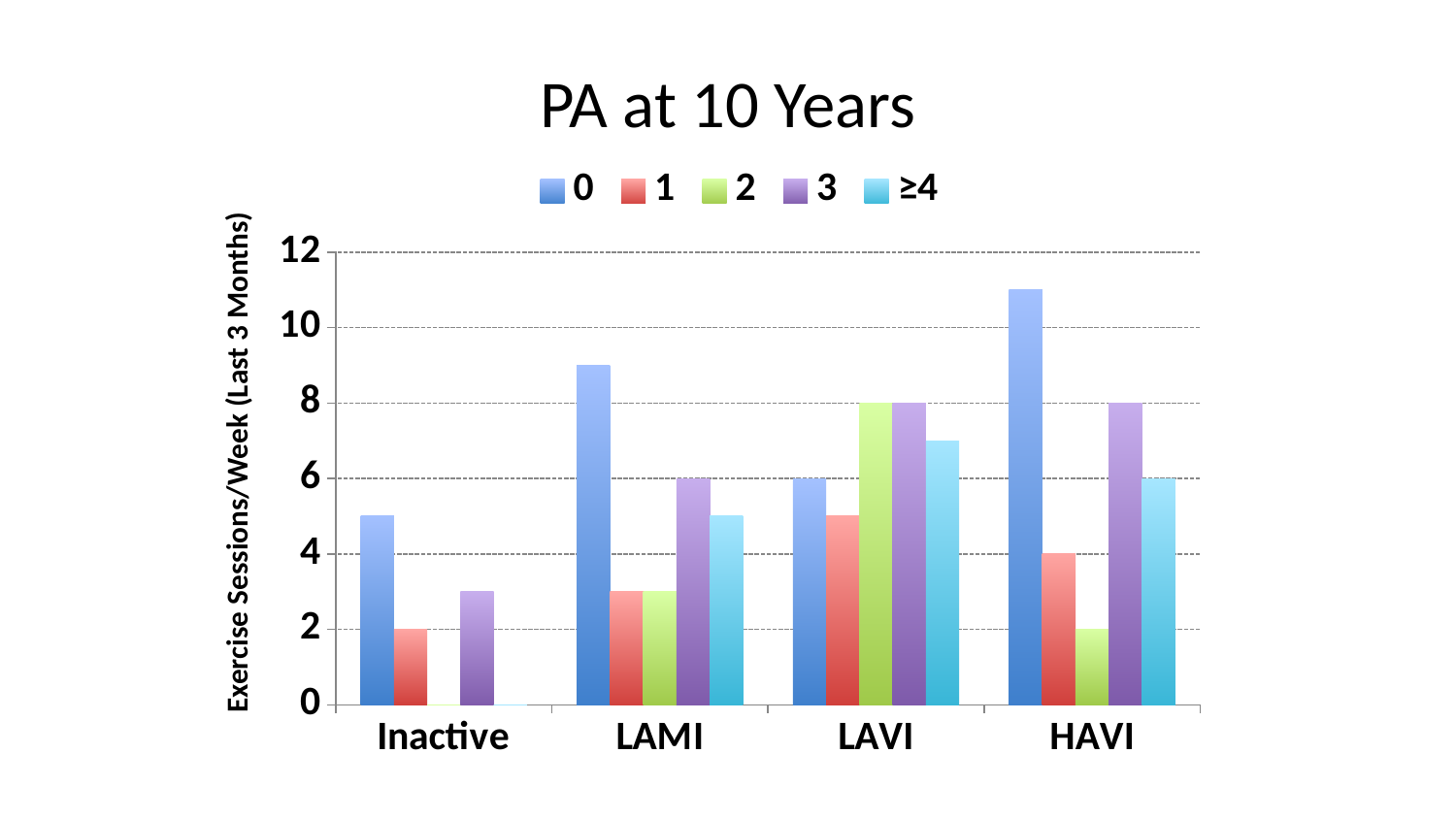
What is the value of series 3 for HAVI? 8 What type of chart is shown on the slide? bar chart What is the value of series 1 for Inactive? 2 How many categories are shown on the x axis? 4 How many series does the legend list? 5 What is the value of series 2 for HAVI? 2 What is the value of series 2 for LAVI? 8 Which series has the lowest value for HAVI? 2 Which is larger, series 0 for LAMI or series 0 for LAVI? LAMI Is the value of series 0 for HAVI greater or less than 10? greater What is the difference between series 3 and series 2 for HAVI? 6 Which category has the highest bar for series 0? HAVI